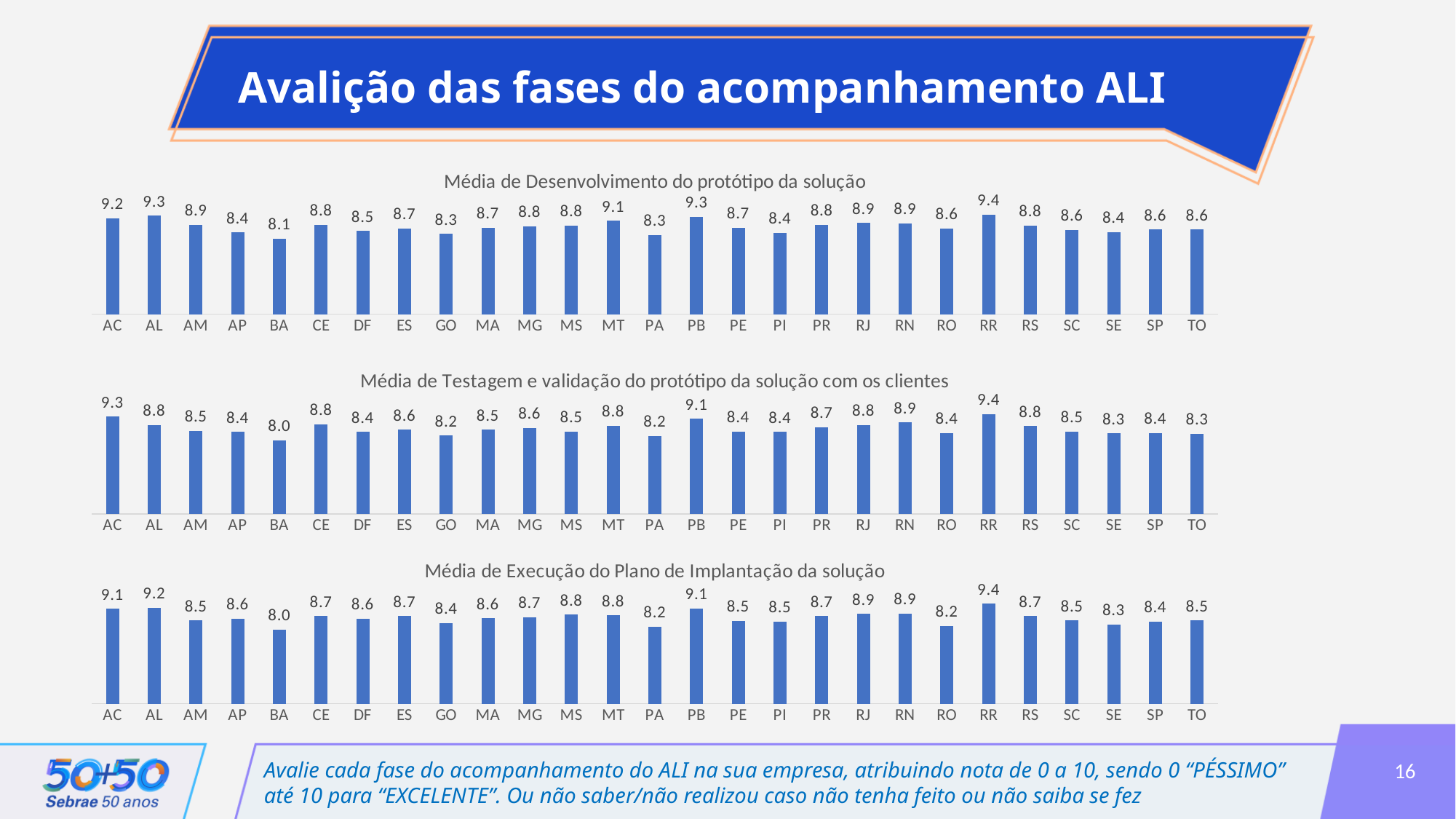
In the chart 'Média de Testagem e validação do protótipo da solução com os clientes', what is the value for AC? 9.3 What type of chart is 'Média de Desenvolvimento do protótipo da solução'? Bar chart In the chart 'Média de Testagem e validação do protótipo da solução com os clientes', what is the value for BA? 8.0 In the chart 'Média de Execução do Plano de Implantação da solução', what is the difference between the values for AL and RO? 1.0 In the chart 'Média de Testagem e validação do protótipo da solução com os clientes', which category has the highest value? RR In the chart 'Média de Desenvolvimento do protótipo da solução', which category has the lowest value? BA In the chart 'Média de Desenvolvimento do protótipo da solução', what is the value for RR? 9.4 In the chart 'Média de Execução do Plano de Implantação da solução', which category has the highest value? RR In the chart 'Média de Testagem e validação do protótipo da solução com os clientes', which is larger, the value for PB or the value for MT? PB In the chart 'Média de Execução do Plano de Implantação da solução', what is the value for PA? 8.2 In the chart 'Média de Desenvolvimento do protótipo da solução', what is the difference between the values for AL and BA? 1.2 How many categories are shown in the chart 'Média de Execução do Plano de Implantação da solução'? 27